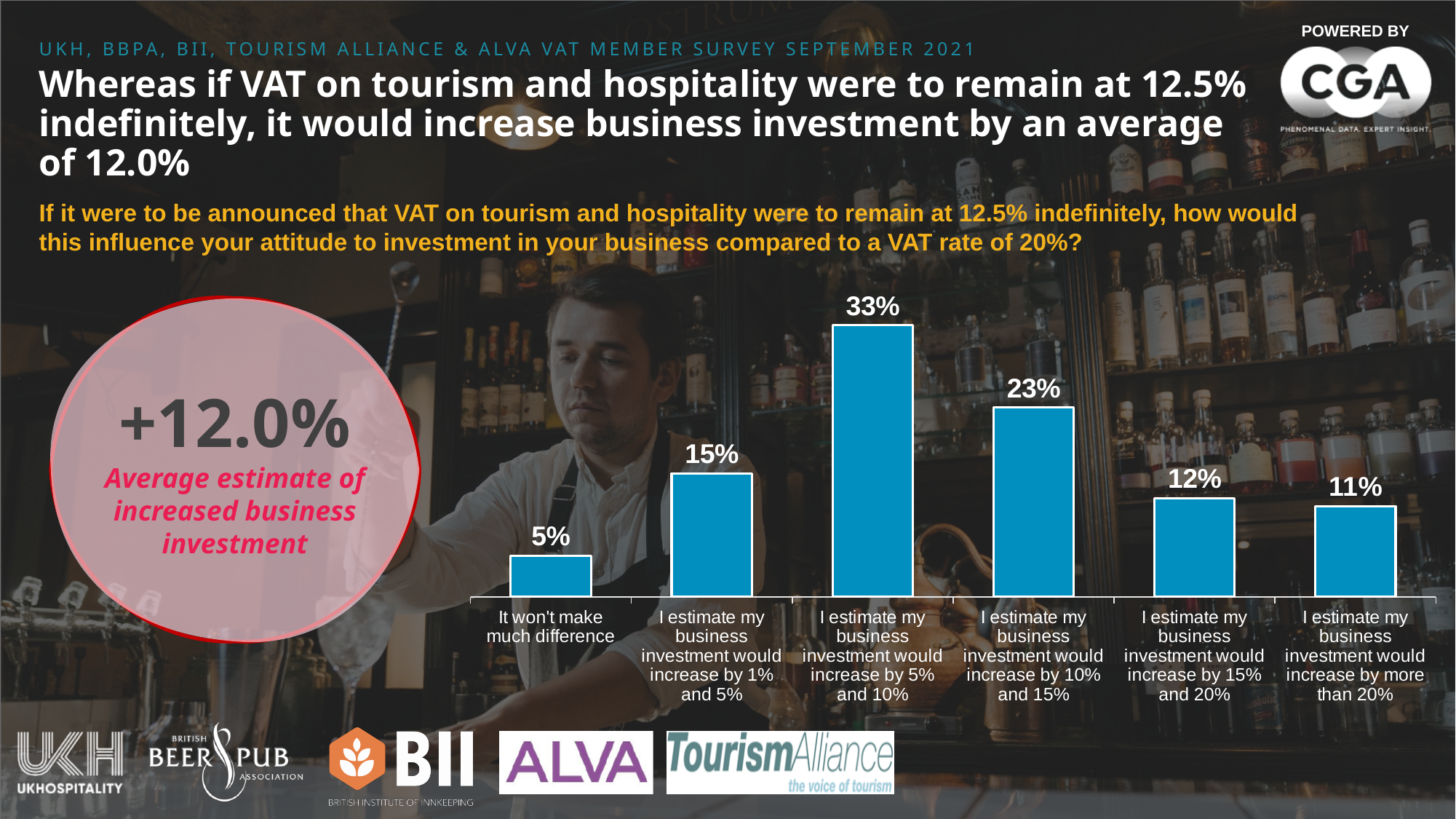
Which response category has the lowest value? It won't make much difference What percentage of respondents said it won't make much difference? 5% What percentage of respondents estimate their business investment would increase by between 5% and 10%? 33% How many response categories are shown in the bar chart? 6 What percentage of respondents estimate their business investment would increase by between 15% and 20%? 12% What type of chart is used to show the survey responses? Bar chart What is the difference between the share estimating an increase of 5% to 10% and the share estimating an increase of 10% to 15%? 10% What is the average estimate of increased business investment shown in the circle on the slide? +12.0% What percentage of respondents estimate their business investment would increase by more than 20%? 11% What is the difference between the share estimating an increase of 1% to 5% and the share saying it won't make much difference? 10% Which is larger: the share estimating an increase of 1% to 5% or the share estimating an increase of 15% to 20%? I estimate my business investment would increase by 1% and 5% Which response category has the highest value? I estimate my business investment would increase by 5% and 10%